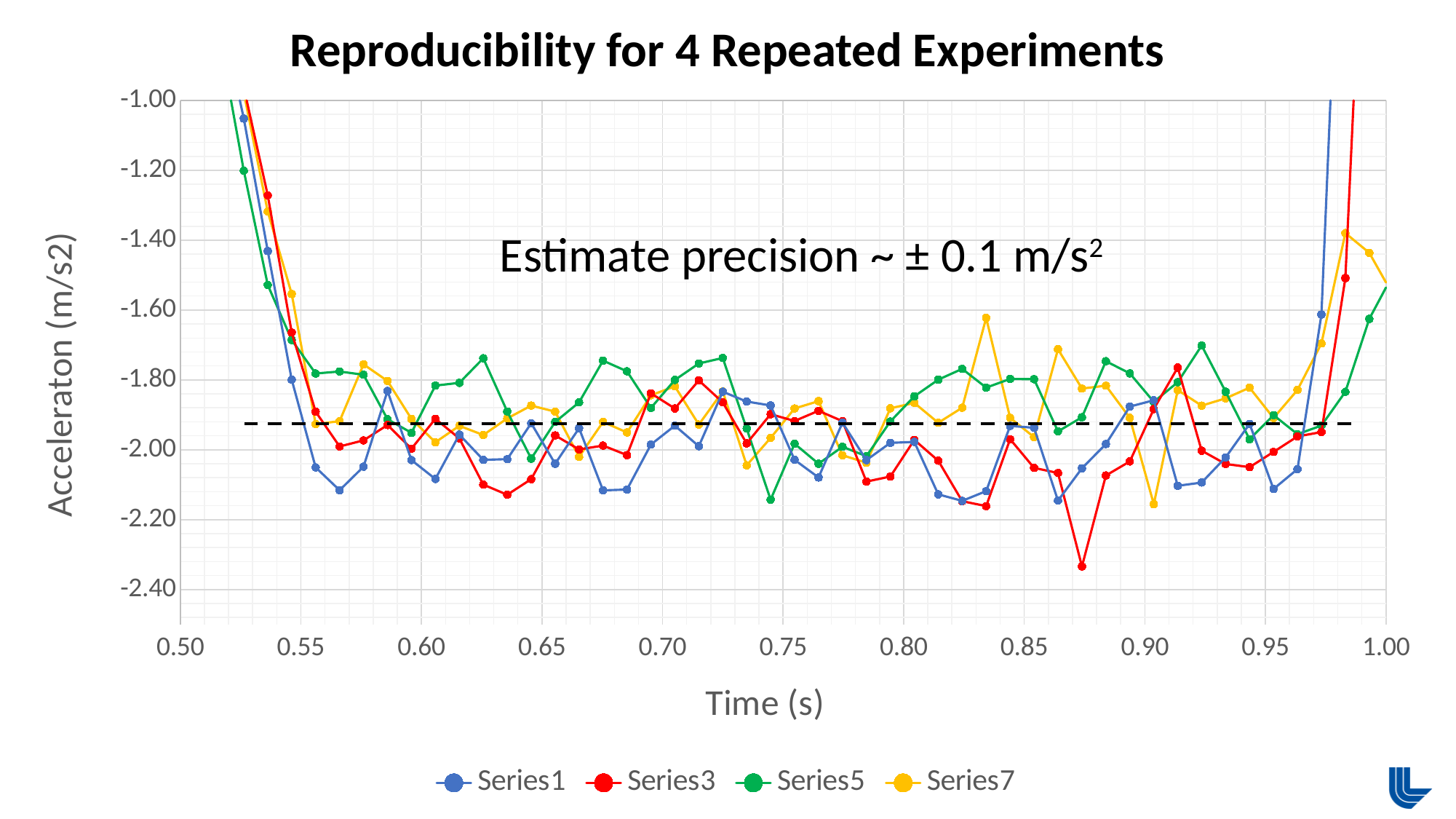
Near 0.835 s, which series has the higher value, Series7 or Series1? Series7 What kind of chart is shown on the slide? line chart Do the series values rise or fall between 0.95 s and 1.00 s? rise Which series reaches the lowest acceleration value on the chart? Series3 Is the lowest value of Series3 (near 0.875 s) greater or less than -2.20? less What is the title of the chart? Reproducibility for 4 Repeated Experiments What is the label of the x axis? Time (s) Is the peak value of Series7 near 0.835 s greater or less than -1.80? greater Is the value of Series7 near 0.905 s greater or less than -2.00? less How many series does the legend list? 4